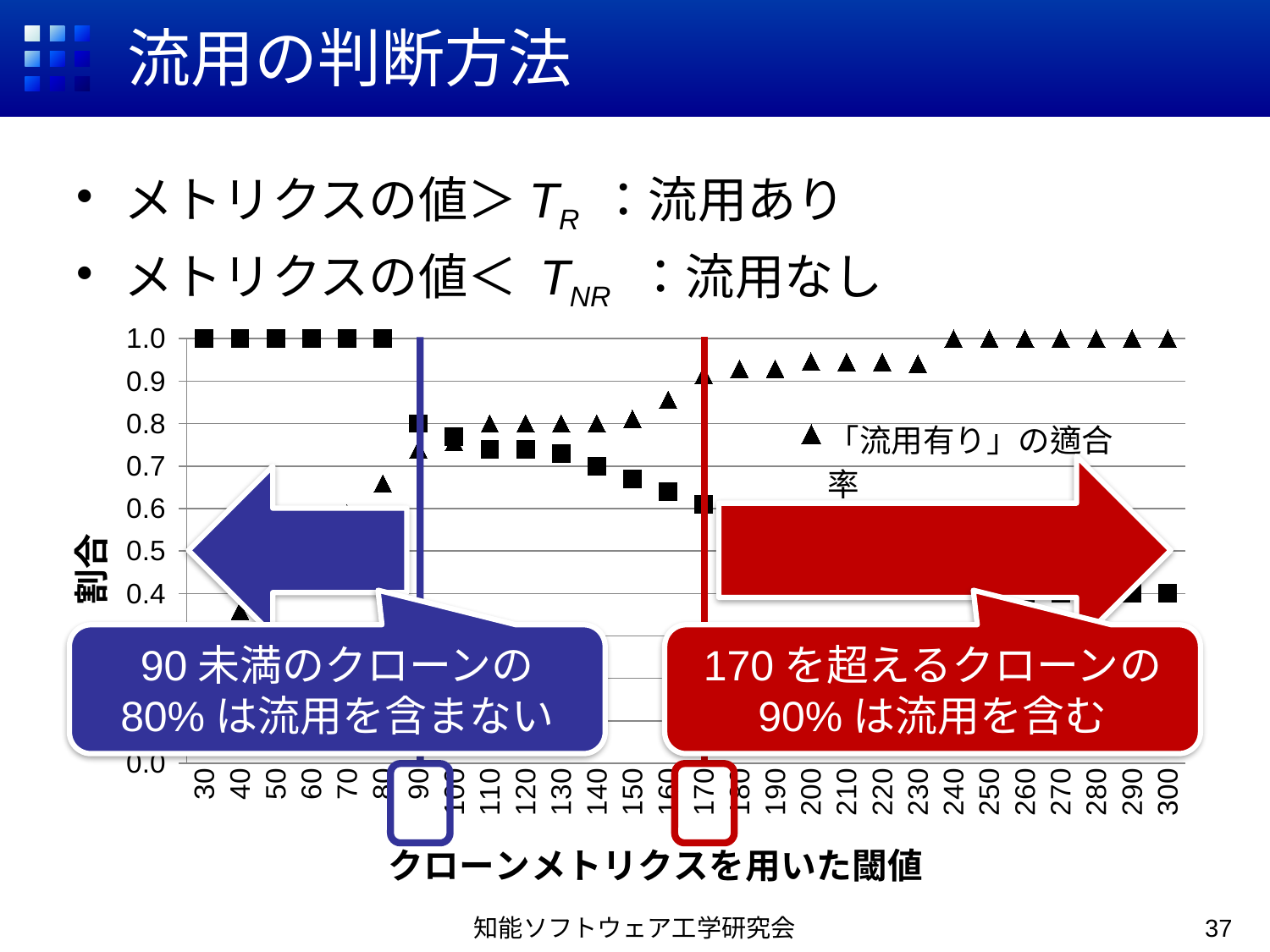
Does the 「流用有り」の適合率 (triangle) series rise or fall as the threshold on the x axis increases? rise Which series does the triangle marker represent according to the legend? 「流用有り」の適合率 What is the title of the x axis of the chart? クローンメトリクスを用いた閾値 Is the value of the 「流用有り」の適合率 (triangle) series at x = 200 greater or less than 0.9? greater Is the value of the square-marker series at x = 300 greater or less than 0.5? less What kind of chart is shown on the slide? scatter chart At x = 80, which series has the larger value: the triangle series or the square series? the square series Is the value of the square-marker series at x = 170 greater or less than 0.7? less What is the value of the square-marker series at x = 30? 1.0 How many threshold values are labelled on the x axis? 28 What is the value of the 「流用有り」の適合率 (triangle) series at x = 300? 1.0